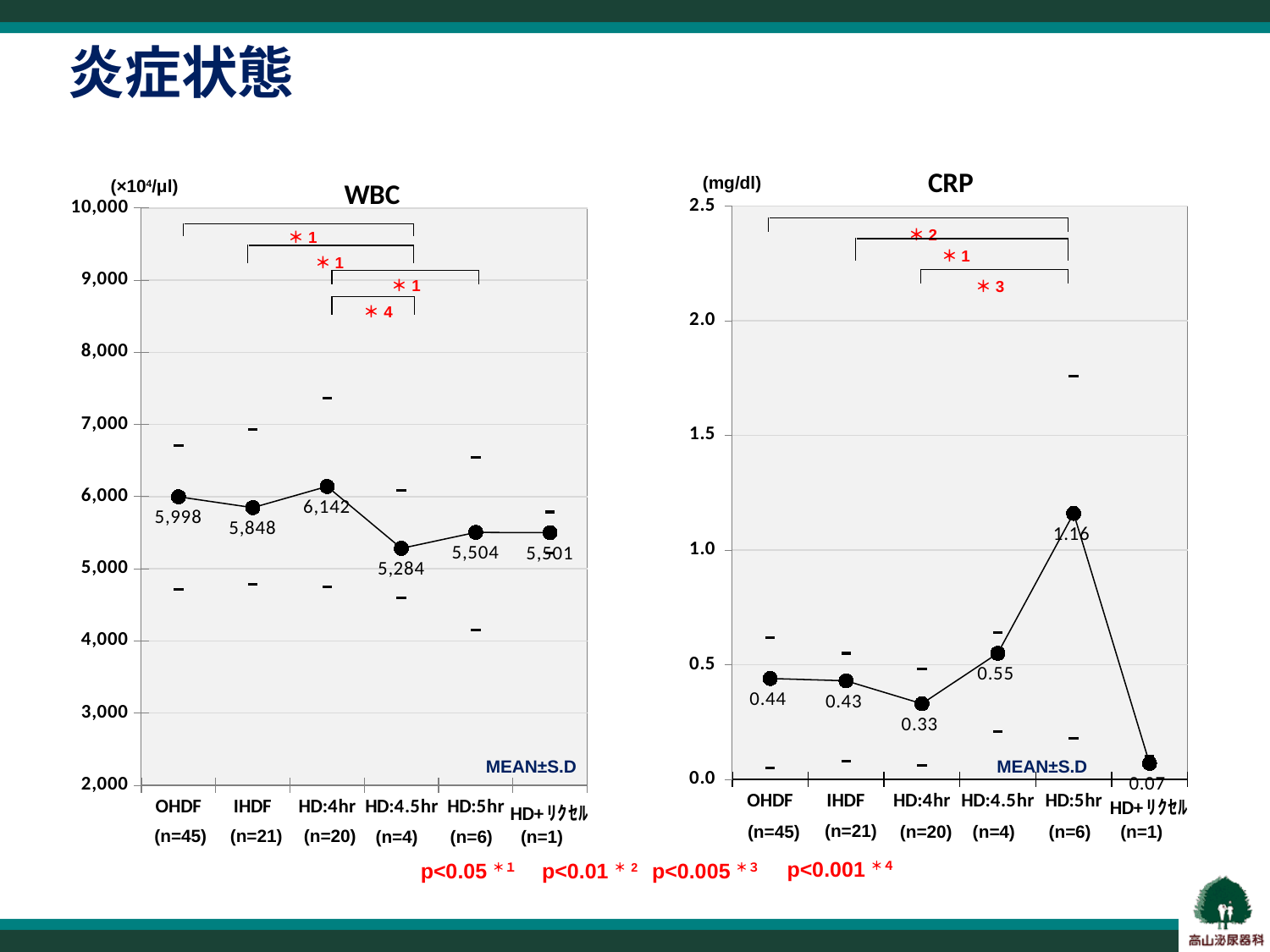
In the WBC chart, which category has the lowest value? HD:4.5hr In the CRP chart, is the value for OHDF greater or less than 0.5? less In the CRP chart, what is the difference between the values for HD:5hr and HD:4.5hr? 0.61 In the WBC chart, which category has the highest value? HD:4hr In the WBC chart, what is the value for HD:4.5hr? 5,284 In the CRP chart, what is the value for HD:5hr? 1.16 In the CRP chart, what is the value for HD+リクセル? 0.07 In the WBC chart, what is the value for HD:4hr? 6,142 How many categories are plotted on the x axis of the WBC chart? 6 In the CRP chart, which category has the highest value? HD:5hr In the WBC chart, what is the difference between the values for OHDF and IHDF? 150 In the CRP chart, which category has the lowest value? HD+リクセル